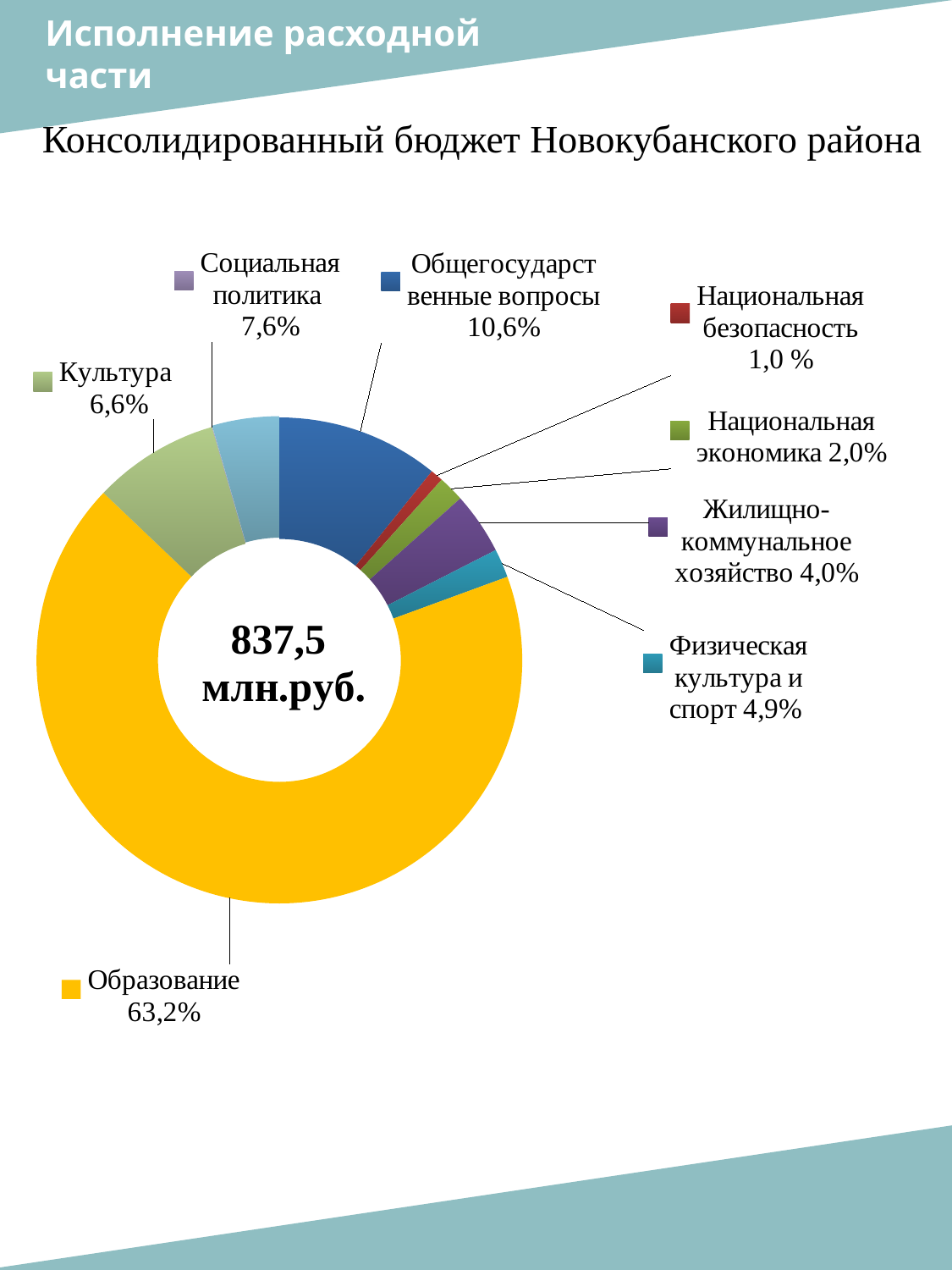
What colour is the Образование segment? Yellow What percentage is shown for Физическая культура и спорт? 4,9% What percentage is shown for Общегосударственные вопросы? 10,6% How many categories are shown in the chart? 8 What share of the budget goes to Образование? 63,2% What is the difference in percentage points between Социальная политика and Культура? 1,0 What total amount is shown in the centre of the chart? 837,5 млн.руб. What percentage is shown for Жилищно-коммунальное хозяйство? 4,0% Which category has the largest share of the budget? Образование Which category has the smallest share of the budget? Национальная безопасность Which is larger: the share for Национальная экономика or for Национальная безопасность? Национальная экономика What type of chart is shown on the slide? Pie (doughnut) chart